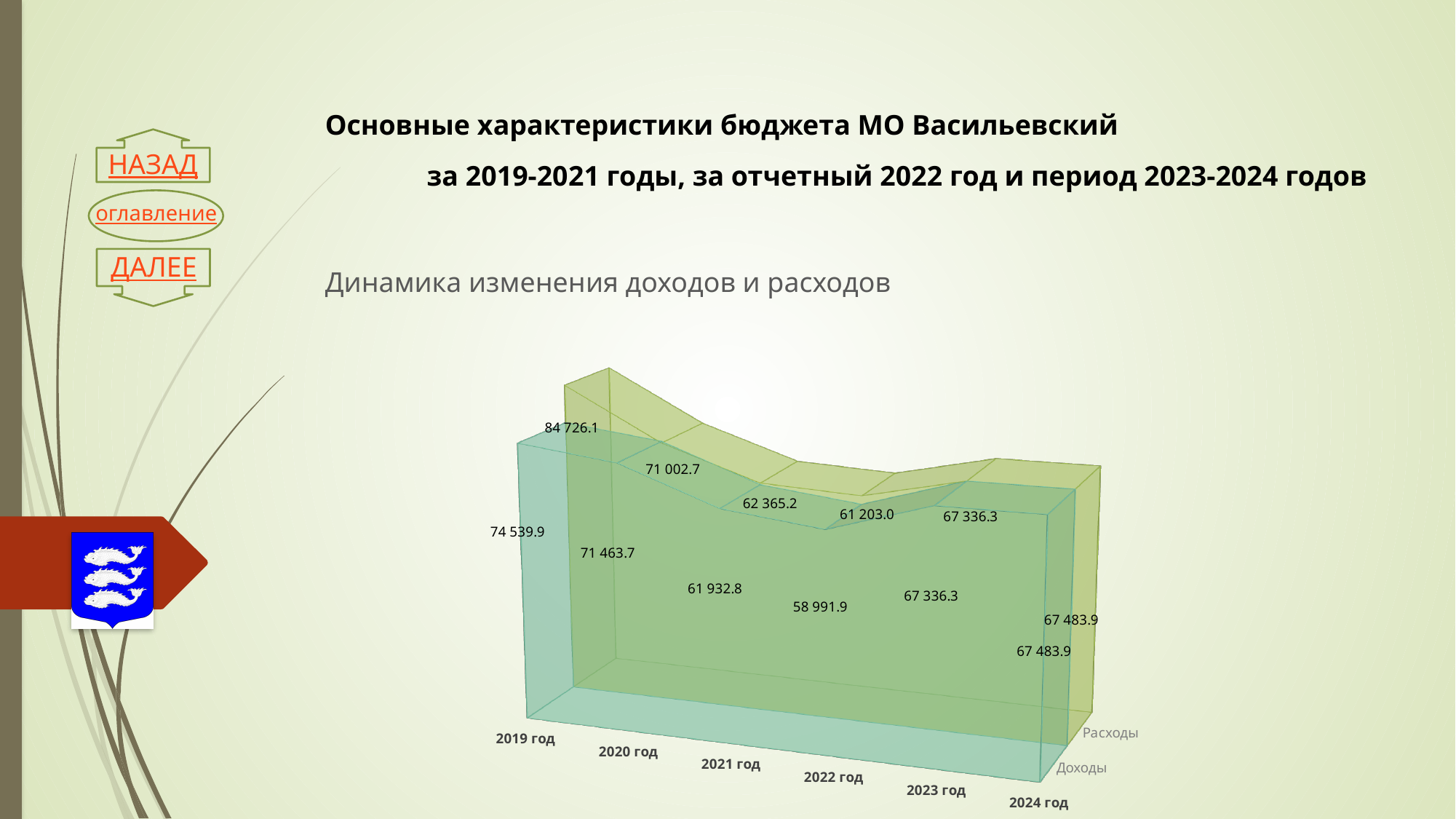
In which year is Расходы highest? 2019 год Which is larger in 2019 год, Расходы or Доходы? Расходы Do the Расходы values rise or fall from 2019 год to 2022 год? fall What is the difference between Расходы and Доходы in 2022 год? 2 211.1 What is the value of Расходы for 2019 год? 84 726.1 How many years are shown on the x axis? 6 What is the value of Доходы for 2020 год? 71 463.7 What is the difference between Расходы and Доходы in 2019 год? 10 186.2 In which year is Доходы lowest? 2022 год What is the value of Расходы for 2021 год? 62 365.2 How many series does the chart show? 2 What is the value of Доходы for 2022 год? 58 991.9